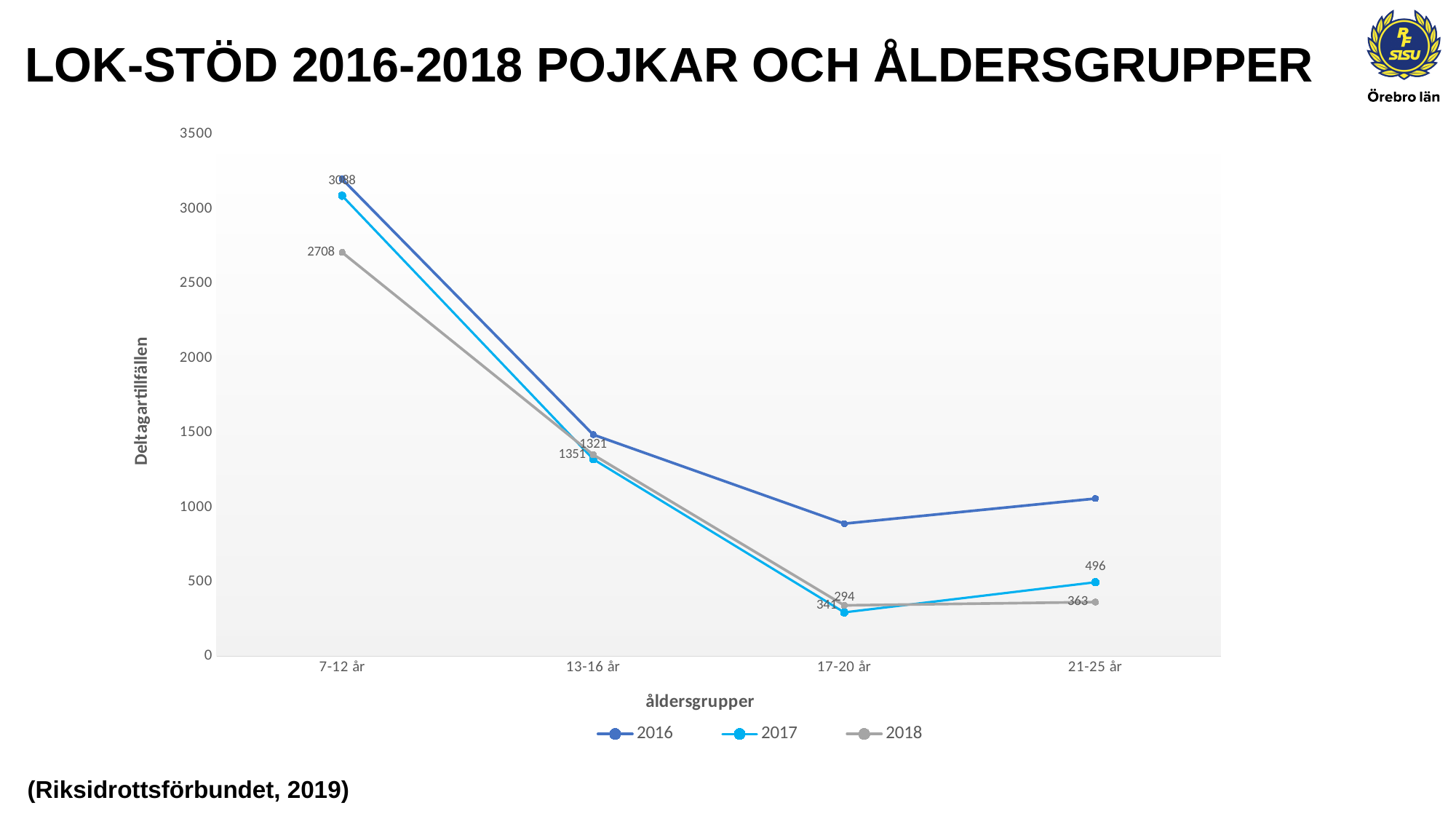
What kind of chart is shown on the slide? line chart Which age group has the highest value for the 2018 series? 7-12 år Is the value for 2016 in the 17-20 år age group greater or less than 1000? less Which series has the larger value in the 21-25 år age group, 2016 or 2017? 2016 What is the value for 2018 in the 7-12 år age group? 2708 What is the value for 2017 in the 21-25 år age group? 496 What is the difference between the 2017 and 2018 values in the 13-16 år age group? 30 What is the value for 2017 in the 13-16 år age group? 1321 What is the value for 2018 in the 21-25 år age group? 363 How many age groups are shown on the x axis? 4 What is the difference between the 2017 and 2018 values in the 21-25 år age group? 133 How many series does the legend list? 3